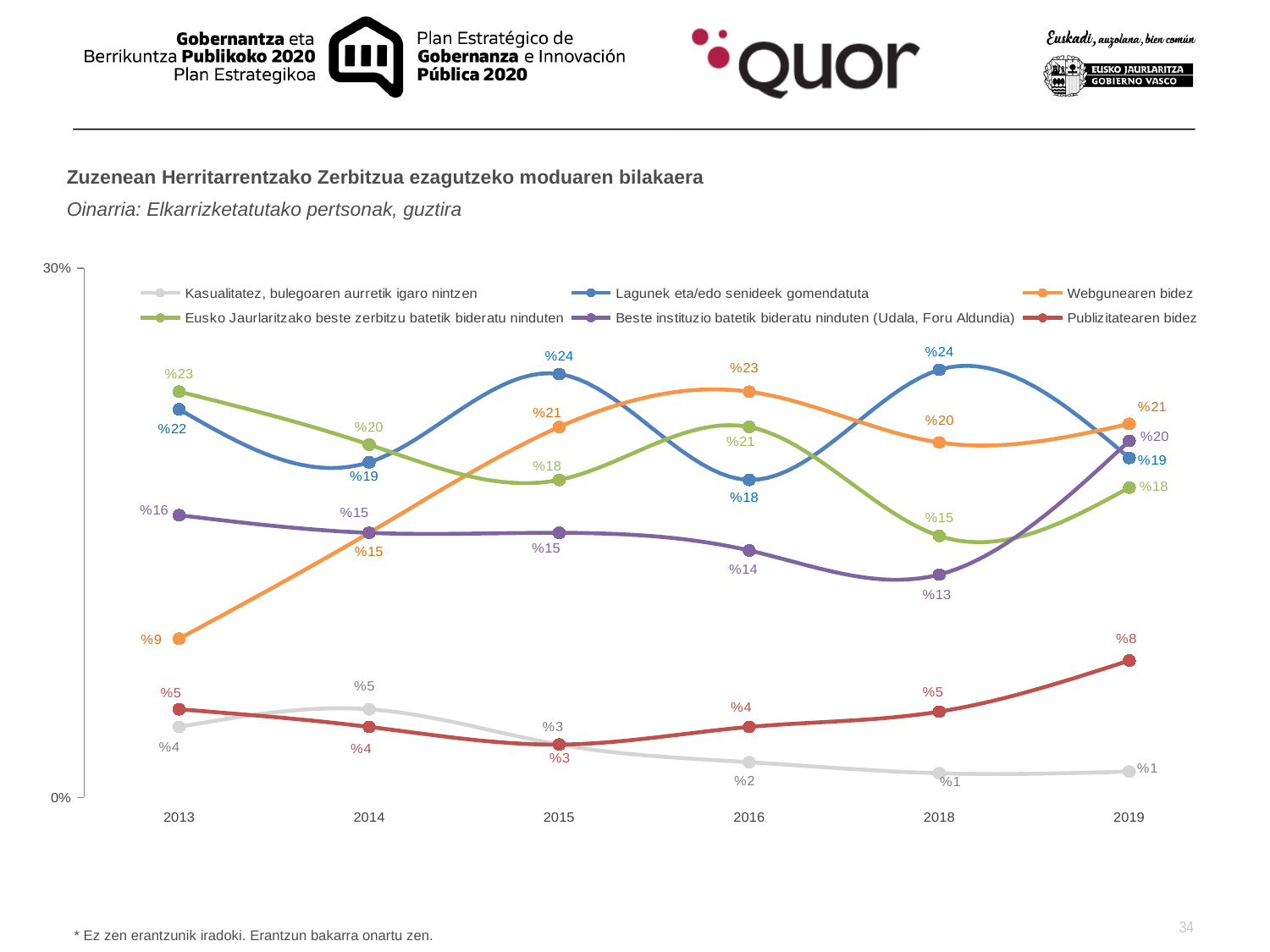
Does the value for 'Kasualitatez, bulegoaren aurretik igaro nintzen' rise or fall from 2014 to 2019? Fall What is the value for 'Publizitatearen bidez' in 2019? %8 What is the value for 'Webgunearen bidez' in 2013? %9 How many series does the legend list? 6 What kind of chart is shown on the slide? Line chart What is the value for 'Lagunek eta/edo senideek gomendatuta' in 2018? %24 In 2013, which is larger: 'Eusko Jaurlaritzako beste zerbitzu batetik bideratu ninduten' or 'Webgunearen bidez'? Eusko Jaurlaritzako beste zerbitzu batetik bideratu ninduten In which year does 'Webgunearen bidez' reach its highest value? 2016 What is the value for 'Beste instituzio batetik bideratu ninduten (Udala, Foru Aldundia)' in 2016? %14 In which year is 'Eusko Jaurlaritzako beste zerbitzu batetik bideratu ninduten' at its lowest value? 2018 How many years are shown on the x axis? 6 What is the difference between the 2019 and 2018 values for 'Beste instituzio batetik bideratu ninduten (Udala, Foru Aldundia)'? 7 percentage points